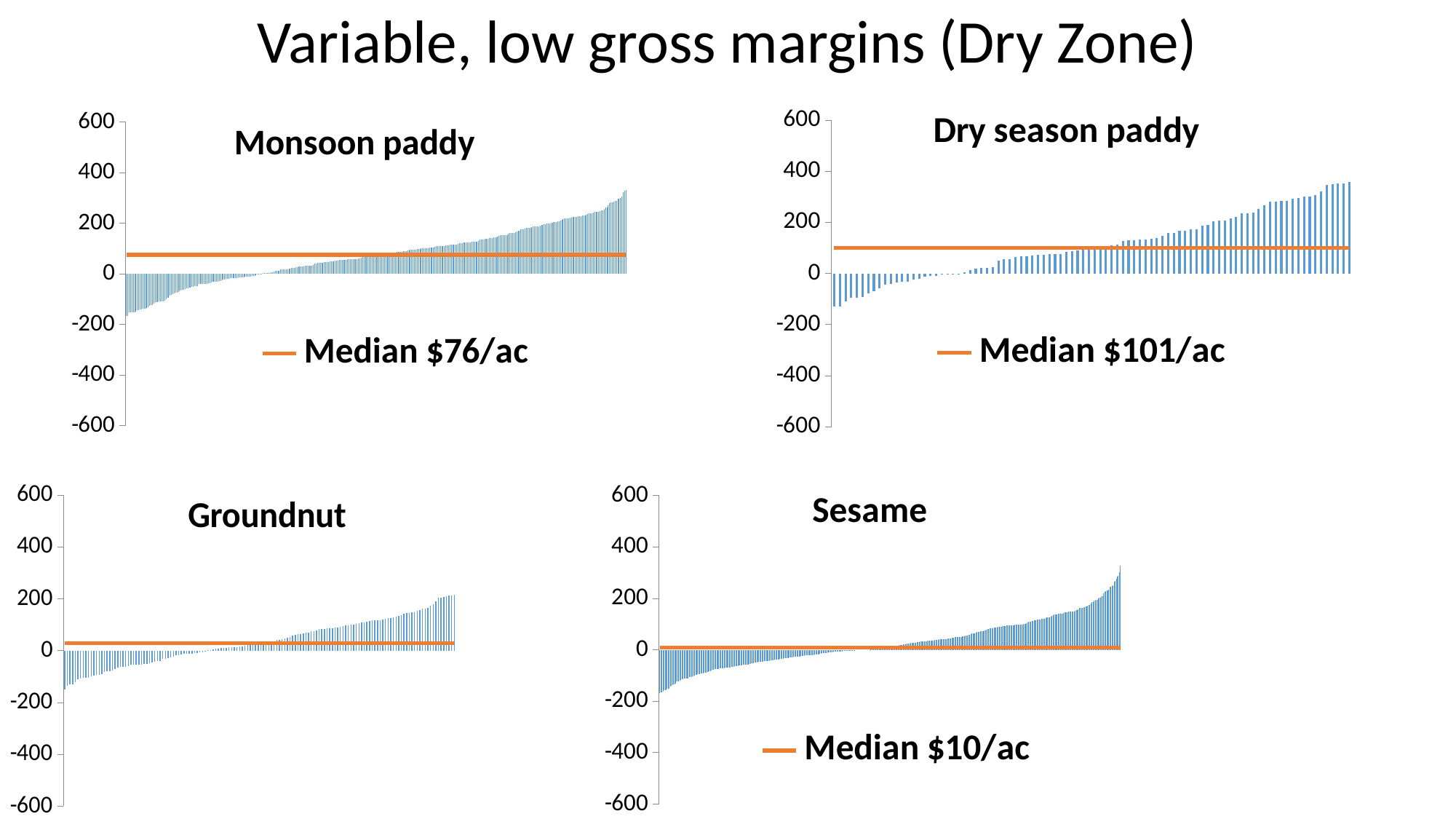
What is the median gross margin shown for the Sesame chart? $10/ac What is the title of the slide? Variable, low gross margins (Dry Zone) Which crop has the higher median gross margin, Monsoon paddy or Dry season paddy? Dry season paddy In the Dry season paddy chart, is the highest bar greater or less than 200? Greater Of the three charts with a printed median, which crop has the lowest median gross margin? Sesame In the Groundnut chart, is the highest bar greater or less than 400? Less In the Sesame chart, do the bar values rise or fall from left to right? Rise What is the median gross margin shown for the Dry season paddy chart? $101/ac What is the median gross margin shown for the Monsoon paddy chart? $76/ac What kind of chart is the Monsoon paddy chart? Bar chart How many charts are shown on the slide? 4 What is the difference between the median gross margins of Dry season paddy and Monsoon paddy? $25/ac